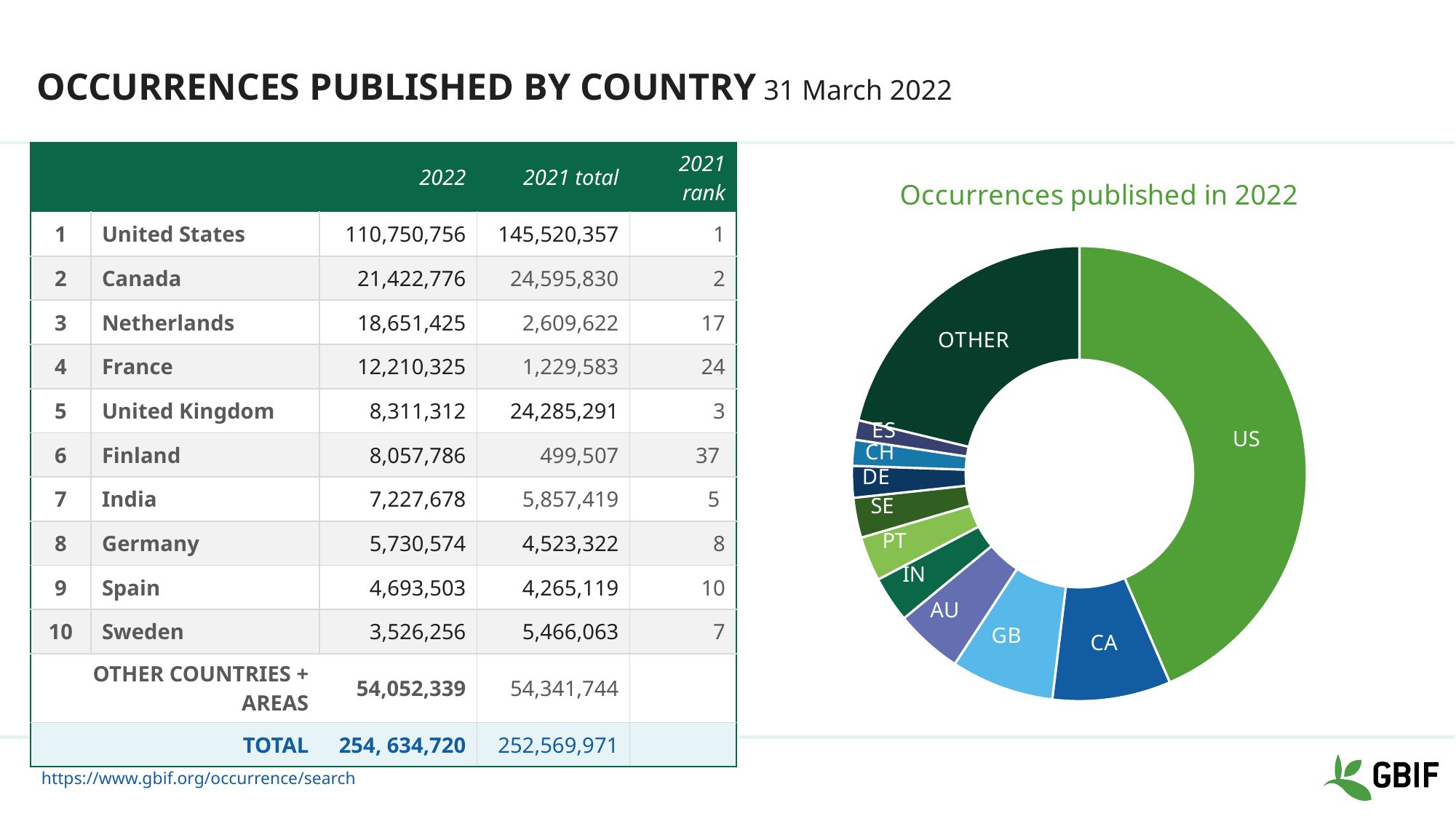
How many slices does the 'Occurrences published in 2022' chart have? 11 In the 'Occurrences published in 2022' chart, which slice is larger, GB or AU? GB What kind of chart is shown on the right of the slide? Pie chart (donut) In the 'Occurrences published in 2022' chart, which slice is larger, CA or GB? CA Which slice in the 'Occurrences published in 2022' chart is the second largest after US? OTHER What is the title of the chart on the right of the slide? Occurrences published in 2022 Which slice is the largest in the 'Occurrences published in 2022' chart? US What date is given in the slide title next to 'OCCURRENCES PUBLISHED BY COUNTRY'? 31 March 2022 Which slice in the 'Occurrences published in 2022' chart is the largest among the individual country slices other than US? CA In the 'Occurrences published in 2022' chart, which slice is larger, US or OTHER? US